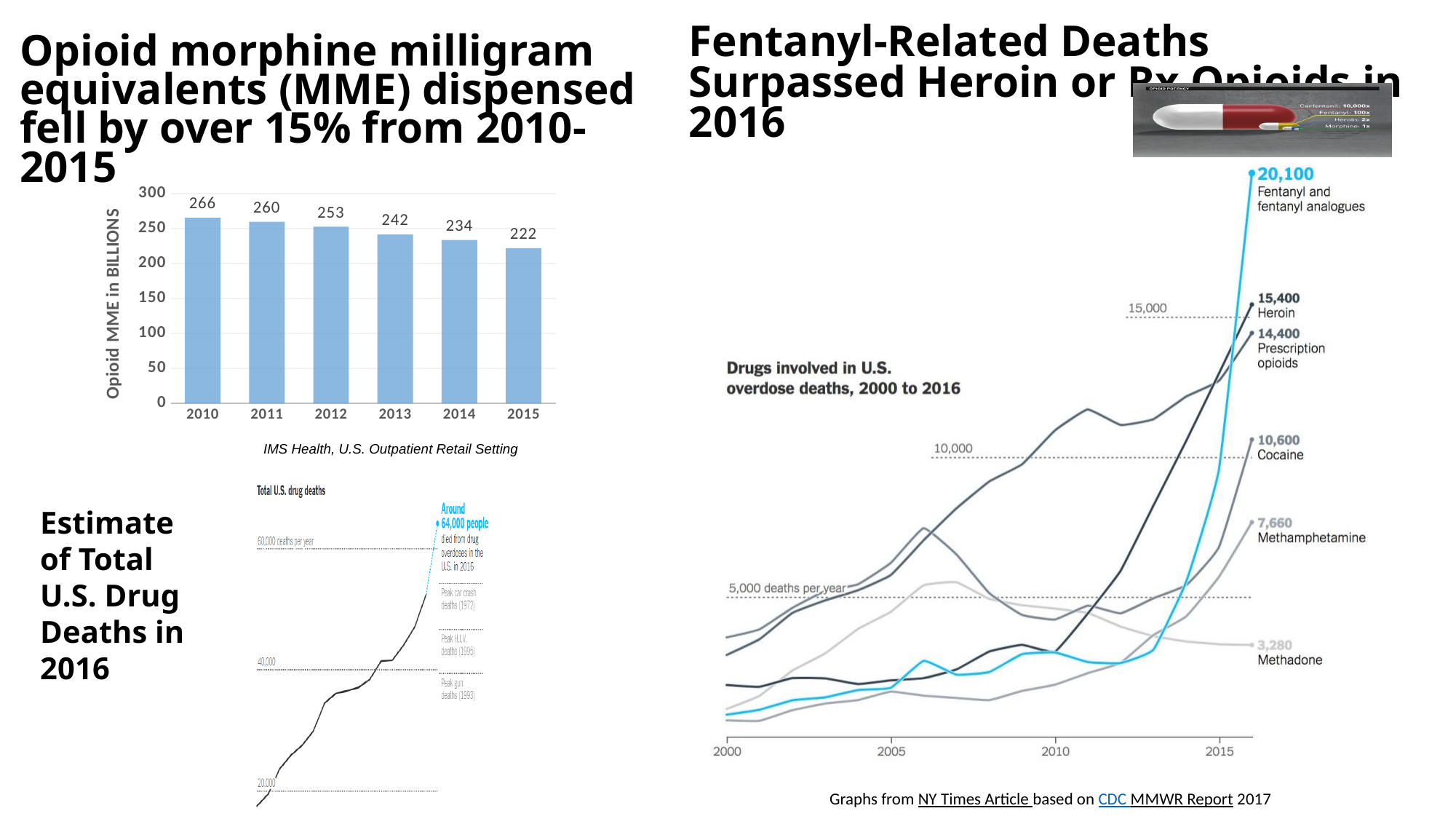
In the chart of drugs involved in U.S. overdose deaths, what is the difference between the 2016 values for fentanyl and fentanyl analogues and heroin? 4,700 In the bar chart of opioid MME dispensed, do the values rise or fall from 2010 to 2015? fall In the chart of drugs involved in U.S. overdose deaths, which drug has the lowest 2016 value? Methadone In the chart of drugs involved in U.S. overdose deaths, which has the larger 2016 value, cocaine or methamphetamine? Cocaine In the bar chart of opioid MME dispensed, what is the difference between the 2010 and 2015 values? 44 How many years are shown in the bar chart of opioid MME dispensed? 6 In the bar chart of opioid MME dispensed, what is the value for 2015? 222 What kind of chart is the opioid MME dispensed chart? bar chart In the chart of drugs involved in U.S. overdose deaths, what is the 2016 value for fentanyl and fentanyl analogues? 20,100 In the bar chart of opioid MME dispensed, what is the value for 2010? 266 In the bar chart of opioid MME dispensed, which year has the highest value? 2010 In the chart of drugs involved in U.S. overdose deaths, what is the 2016 value for heroin? 15,400